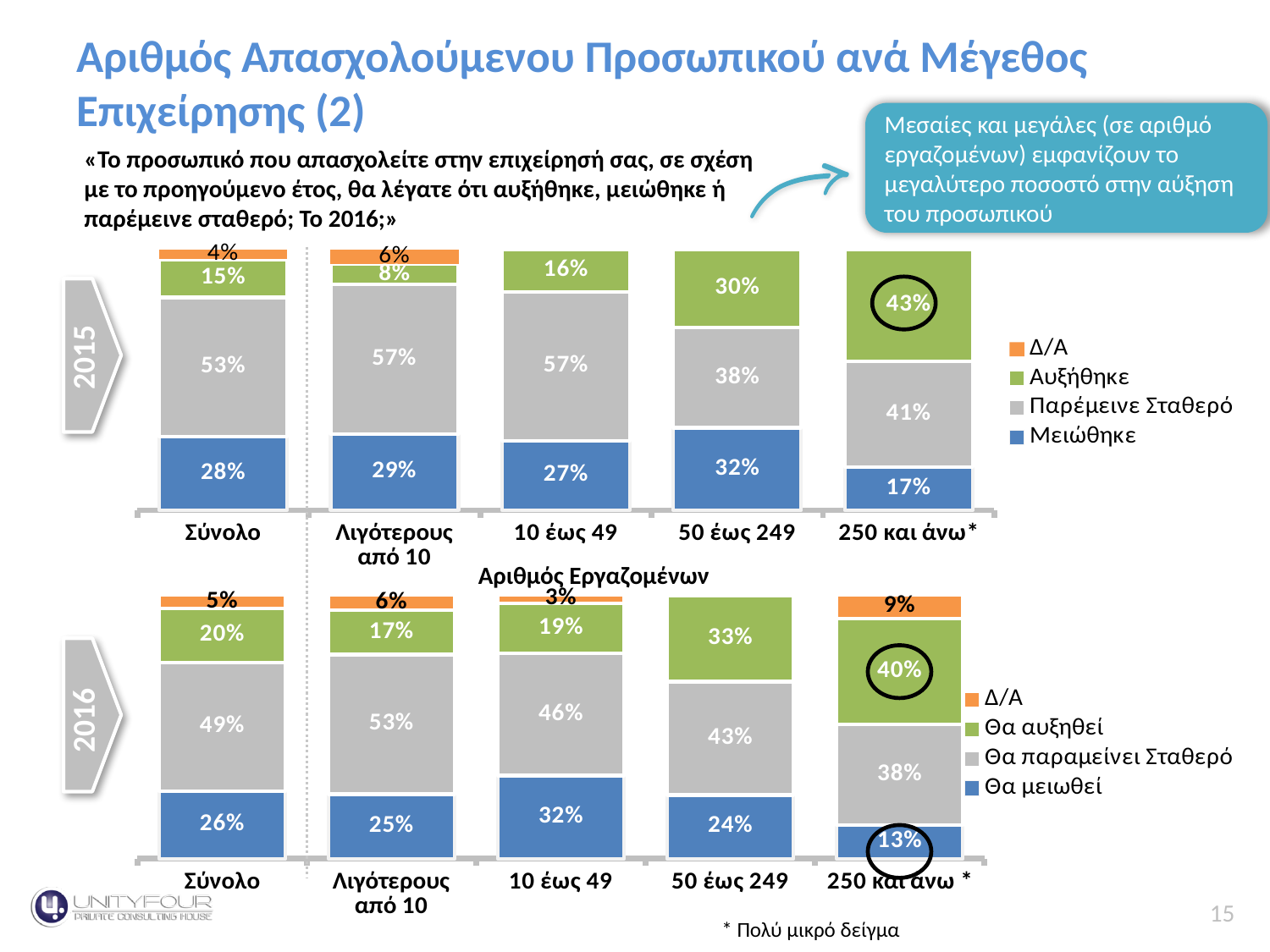
In the 2016 chart (bottom), what is the total of the 'Θα αυξηθεί', 'Θα παραμείνει Σταθερό' and 'Θα μειωθεί' segments for '50 έως 249'? 100% How many series does the legend of the 2015 chart (top) list? 4 In the 2016 chart (bottom), which is larger: 'Θα αυξηθεί' for '50 έως 249' or for '10 έως 49'? 50 έως 249 In the 2015 chart (top), what is the 'Αυξήθηκε' value for '250 και άνω'? 43% In the 2016 chart (bottom), what is the 'Θα μειωθεί' value for '10 έως 49'? 32% In the 2015 chart (top), what is the difference between the 'Μειώθηκε' values for '50 έως 249' and '250 και άνω'? 15% In the 2015 chart (top), what percentage of the 'Σύνολο' bar is 'Παρέμεινε Σταθερό'? 53% In the 2016 chart (bottom), which category has the lowest 'Θα μειωθεί' value? 250 και άνω In the 2016 chart (bottom), what is the 'Δ/Α' value for '250 και άνω'? 9% In the 2015 chart (top), which category has the highest 'Αυξήθηκε' value? 250 και άνω How many categories are shown on the x axis of the 2016 chart (bottom)? 5 What type of chart is the 2015 chart (top)? Stacked bar chart